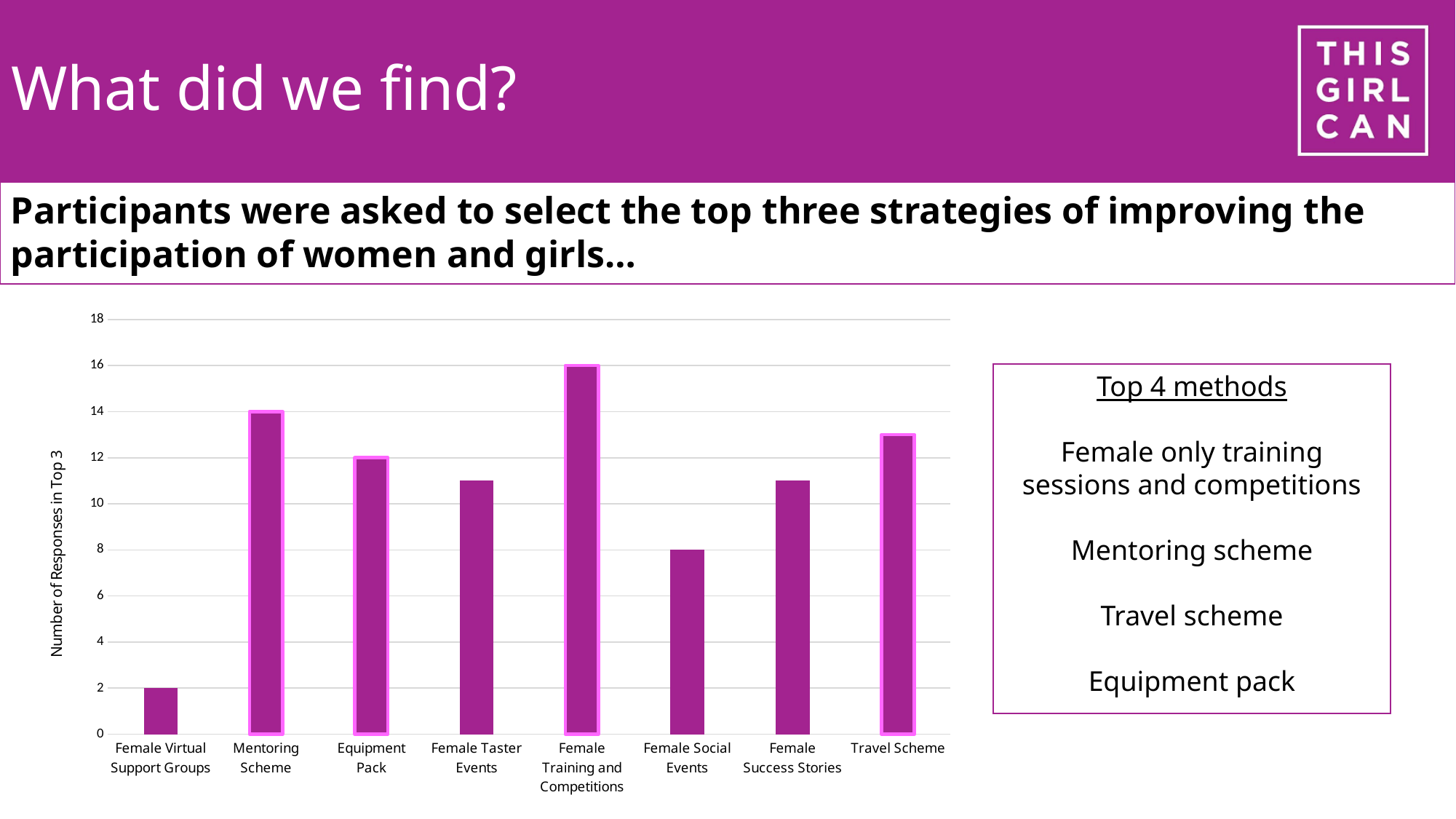
How many responses in the top 3 did Equipment Pack receive? 12 How many responses in the top 3 did Female Social Events receive? 8 Which received more responses, Mentoring Scheme or Equipment Pack? Mentoring Scheme How many strategies (categories) are shown on the x axis of the chart? 8 How many responses in the top 3 did Mentoring Scheme receive? 14 Is the value for Travel Scheme greater or less than 12? greater What is the difference in responses between Female Training and Competitions and Female Virtual Support Groups? 14 How many responses in the top 3 did Female Training and Competitions receive? 16 What type of chart is shown on the slide? Bar chart What is the label of the vertical axis of the chart? Number of Responses in Top 3 Which strategy received the lowest number of responses in the top 3? Female Virtual Support Groups Which strategy received the highest number of responses in the top 3? Female Training and Competitions